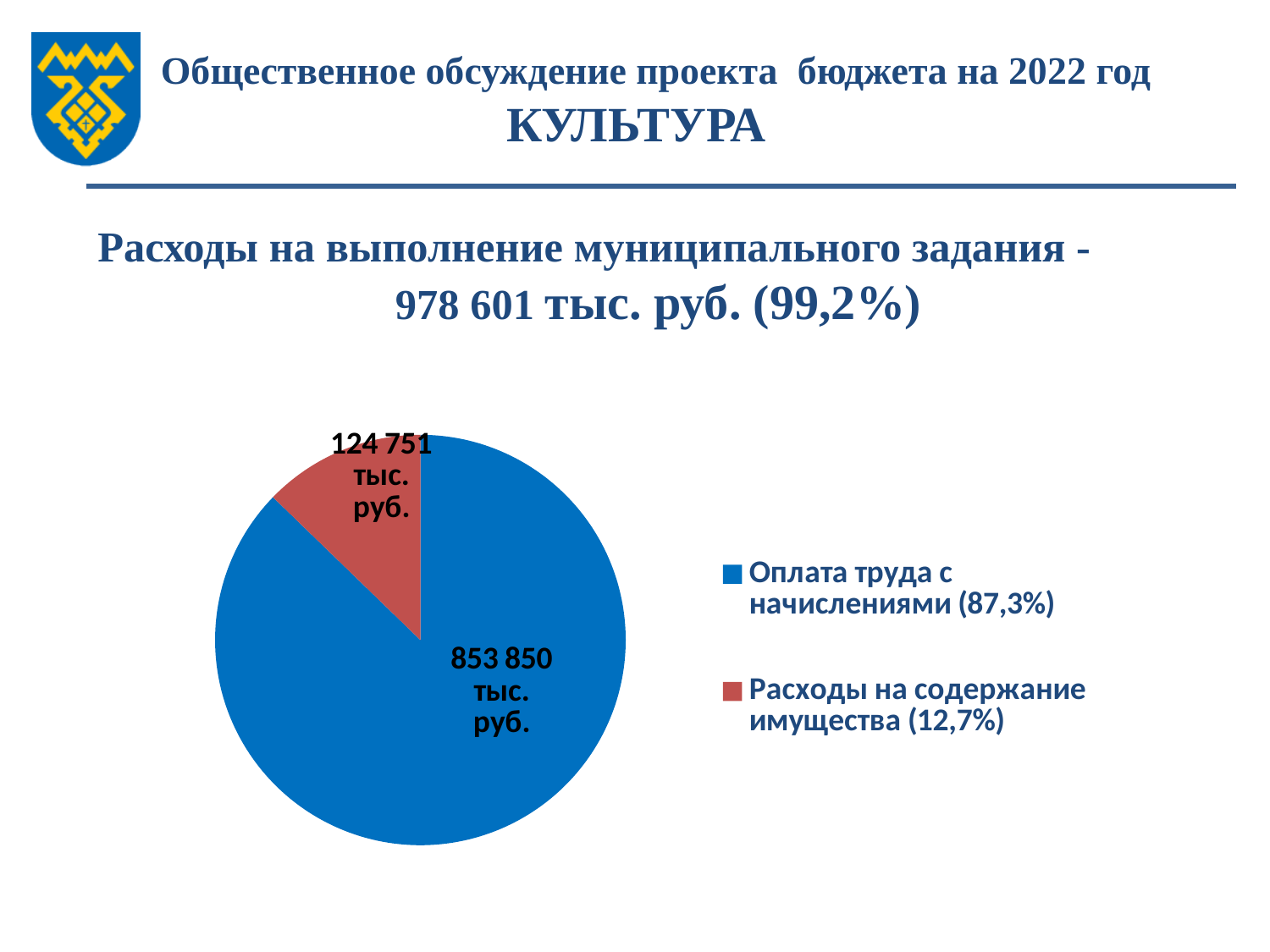
Which category has the largest slice in the pie chart? Оплата труда с начислениями What share of the pie does "Расходы на содержание имущества" represent, according to the legend? 12,7% What is the value shown for "Расходы на содержание имущества" in the pie chart? 124 751 тыс. руб. What kind of chart is shown on the slide? pie chart Which is larger: "Оплата труда с начислениями" or "Расходы на содержание имущества"? Оплата труда с начислениями What is the difference between the values for "Оплата труда с начислениями" and "Расходы на содержание имущества"? 729 099 тыс. руб. What colour is the slice for "Расходы на содержание имущества" in the pie chart? red How many entries does the legend of the pie chart list? 2 How many slices does the pie chart have? 2 What is the value shown for "Оплата труда с начислениями" in the pie chart? 853 850 тыс. руб. What share of the pie does "Оплата труда с начислениями" represent, according to the legend? 87,3% Which category has the smallest slice in the pie chart? Расходы на содержание имущества